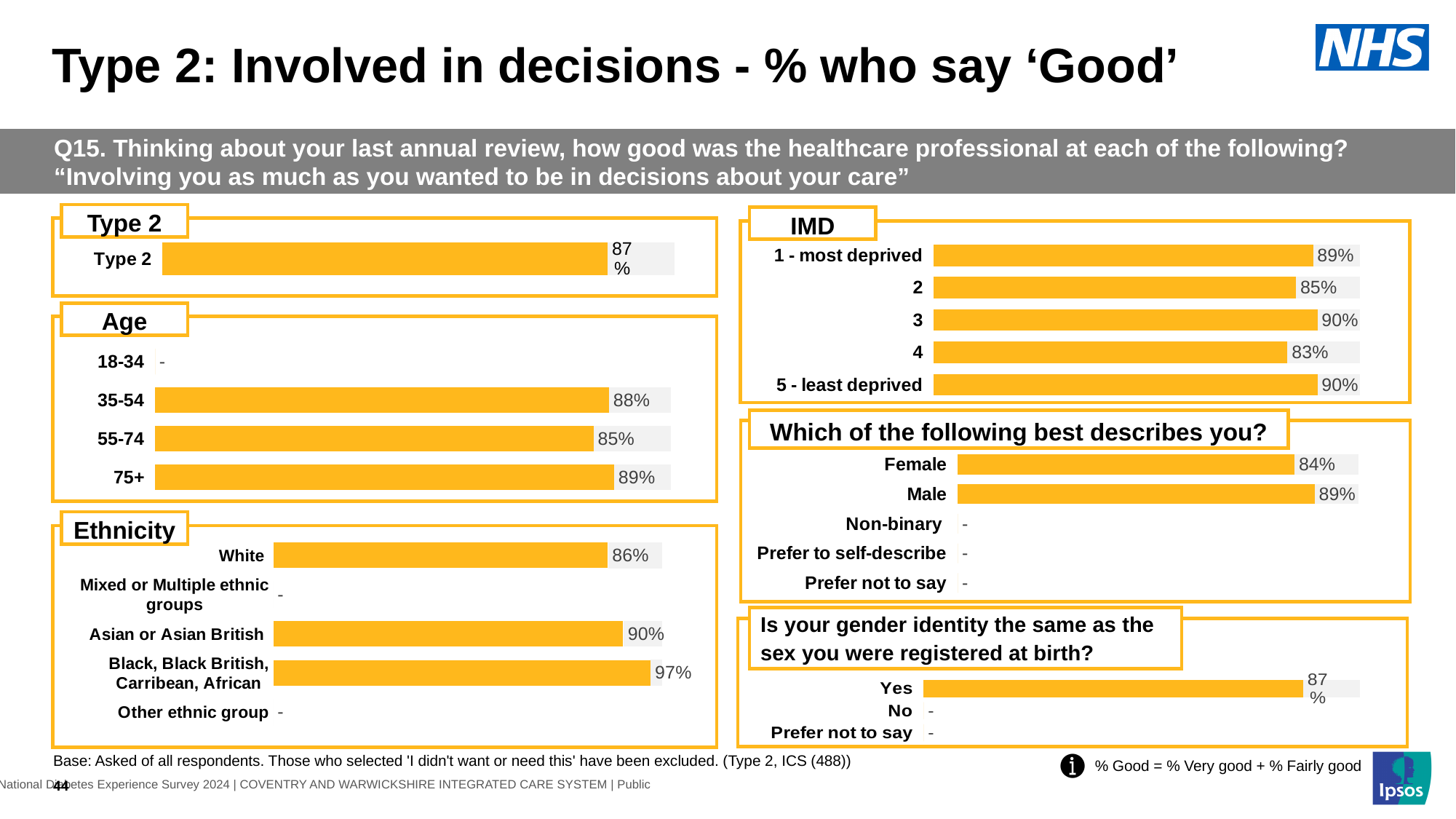
What kind of chart is used in the IMD section? Bar chart In the IMD chart, what is the difference between the values for group 3 and group 4? 7 percentage points How many age groups are listed in the Age chart? 4 In the Age chart, what is the difference between the values for 75+ and 55-74? 4 percentage points In the Type 2 chart, what percentage of Type 2 respondents say 'Good'? 87% In the Ethnicity chart, what is the value for Asian or Asian British? 90% In the 'Is your gender identity the same as the sex you were registered at birth?' chart, what is the value for Yes? 87% In the Ethnicity chart, which ethnic group has the highest value? Black, Black British, Carribean, African In the 'Which of the following best describes you?' chart, which is larger, the value for Female or for Male? Male In the Age chart, what is the value for the 35-54 age group? 88% How many deprivation categories are shown in the IMD chart? 5 In the IMD chart, which deprivation group has the lowest value? 4